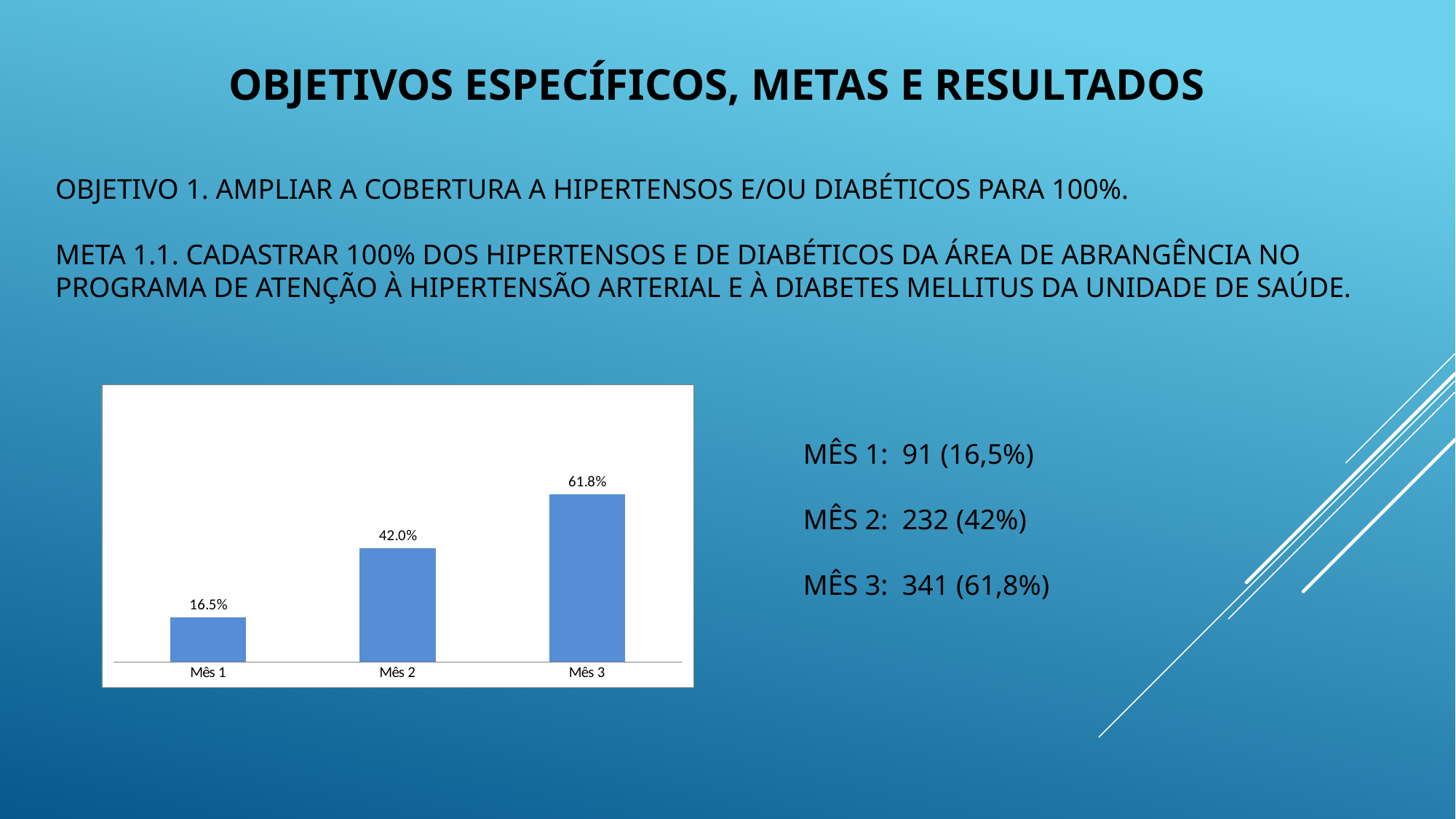
What is the difference between the values for Mês 3 and Mês 2? 19.8% Which is larger, the value for Mês 1 or the value for Mês 2? Mês 2 What kind of chart is shown on the slide? Bar chart What is the value for Mês 3? 61.8% Do the values rise or fall from Mês 1 to Mês 3? Rise Which month has the lowest value? Mês 1 What is the difference between the values for Mês 2 and Mês 1? 25.5% How many bars are shown in the chart? 3 What is the value for Mês 1? 16.5% Which month has the highest value? Mês 3 What colour are the bars in the chart? Blue What is the value for Mês 2? 42.0%